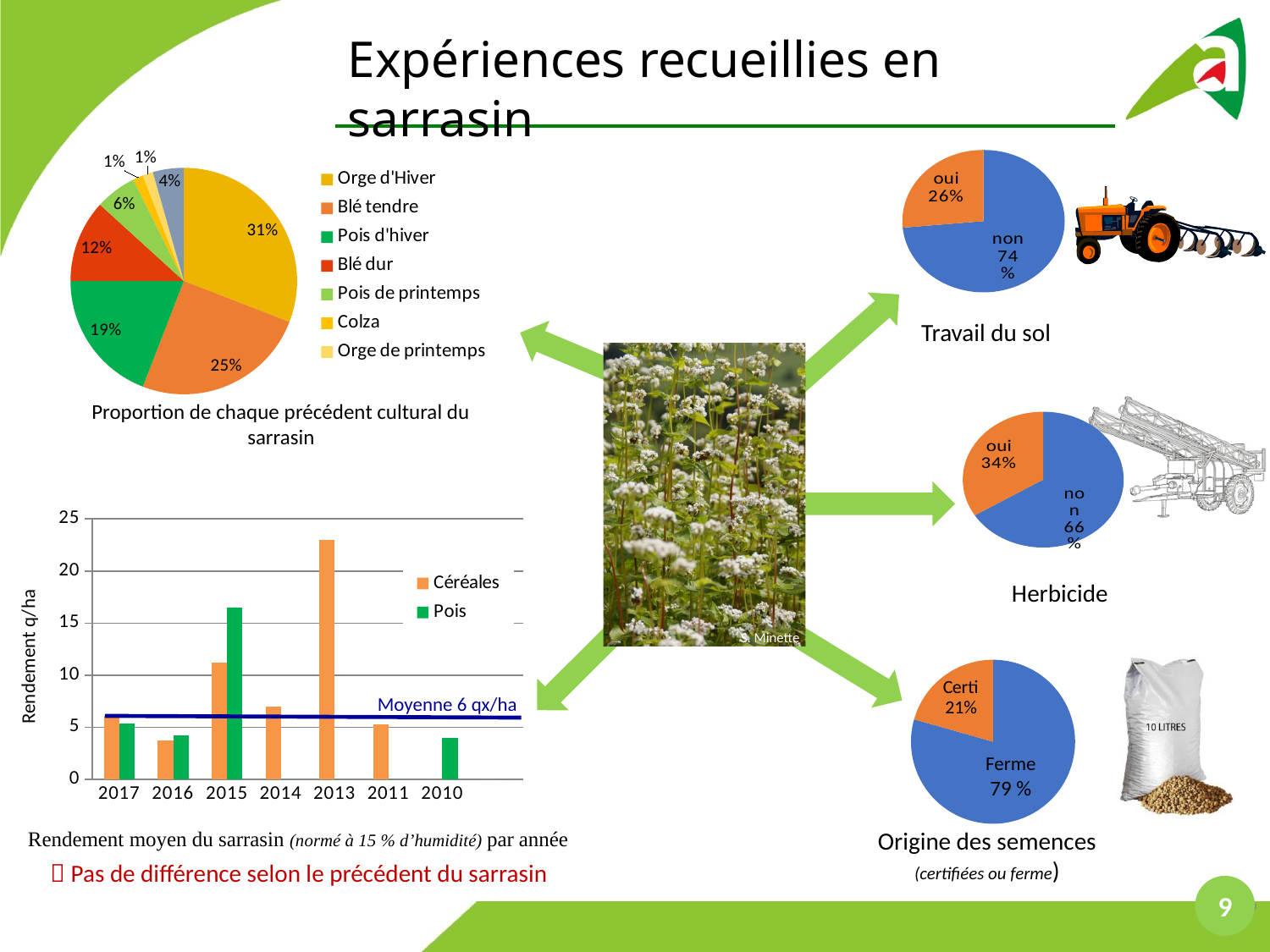
In the bar chart 'Rendement moyen du sarrasin par année', is the Pois value for 2015 greater or less than 15? greater In the pie chart 'Proportion de chaque précédent cultural du sarrasin', what is the difference in percentage points between Pois d'hiver and Blé dur? 7 In the 'Origine des semences' pie chart, what percentage is shown for 'Ferme'? 79 % In the pie chart 'Proportion de chaque précédent cultural du sarrasin', what percentage is shown for Orge d'Hiver? 31% In the bar chart 'Rendement moyen du sarrasin par année', how many years are shown on the x axis? 7 What kind of chart is the 'Rendement moyen du sarrasin par année' chart at the bottom left? bar chart In the pie chart 'Proportion de chaque précédent cultural du sarrasin', what percentage is shown for Blé tendre? 25% In the 'Travail du sol' pie chart, what percentage is shown for 'oui'? 26% In the pie chart 'Proportion de chaque précédent cultural du sarrasin', which legend entry has the largest share? Orge d'Hiver How many entries does the legend of the pie chart 'Proportion de chaque précédent cultural du sarrasin' list? 7 In the bar chart 'Rendement moyen du sarrasin par année', in which year is the Céréales bar highest? 2013 In the 'Herbicide' pie chart, what percentage is shown for 'non'? 66%